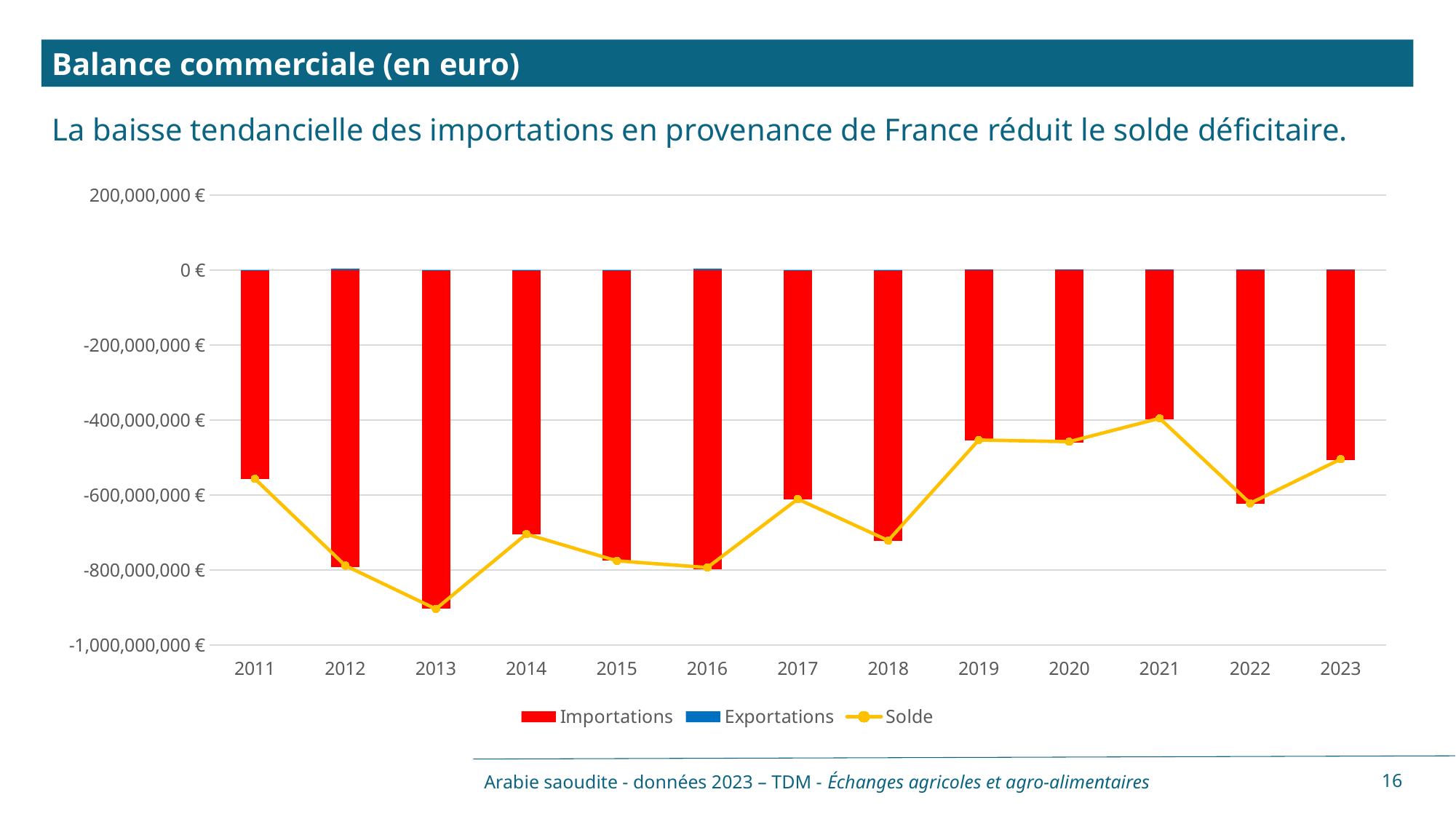
What kind of chart is shown on the slide? bar chart with a line How many years are shown on the x axis of the chart? 13 Is the Importations value for 2013 greater or less than -800,000,000 €? less Is the Importations value for 2011 greater or less than -600,000,000 €? greater What colour are the Importations bars? red Is the Solde value for 2018 greater or less than -600,000,000 €? less Which year has the highest (least negative) Solde value? 2021 Which year has the lower Solde value, 2012 or 2013? 2013 How many series does the chart legend list? 3 Does the Solde line rise or fall from 2018 to 2021? rise Which year has the lowest (most negative) Importations value? 2013